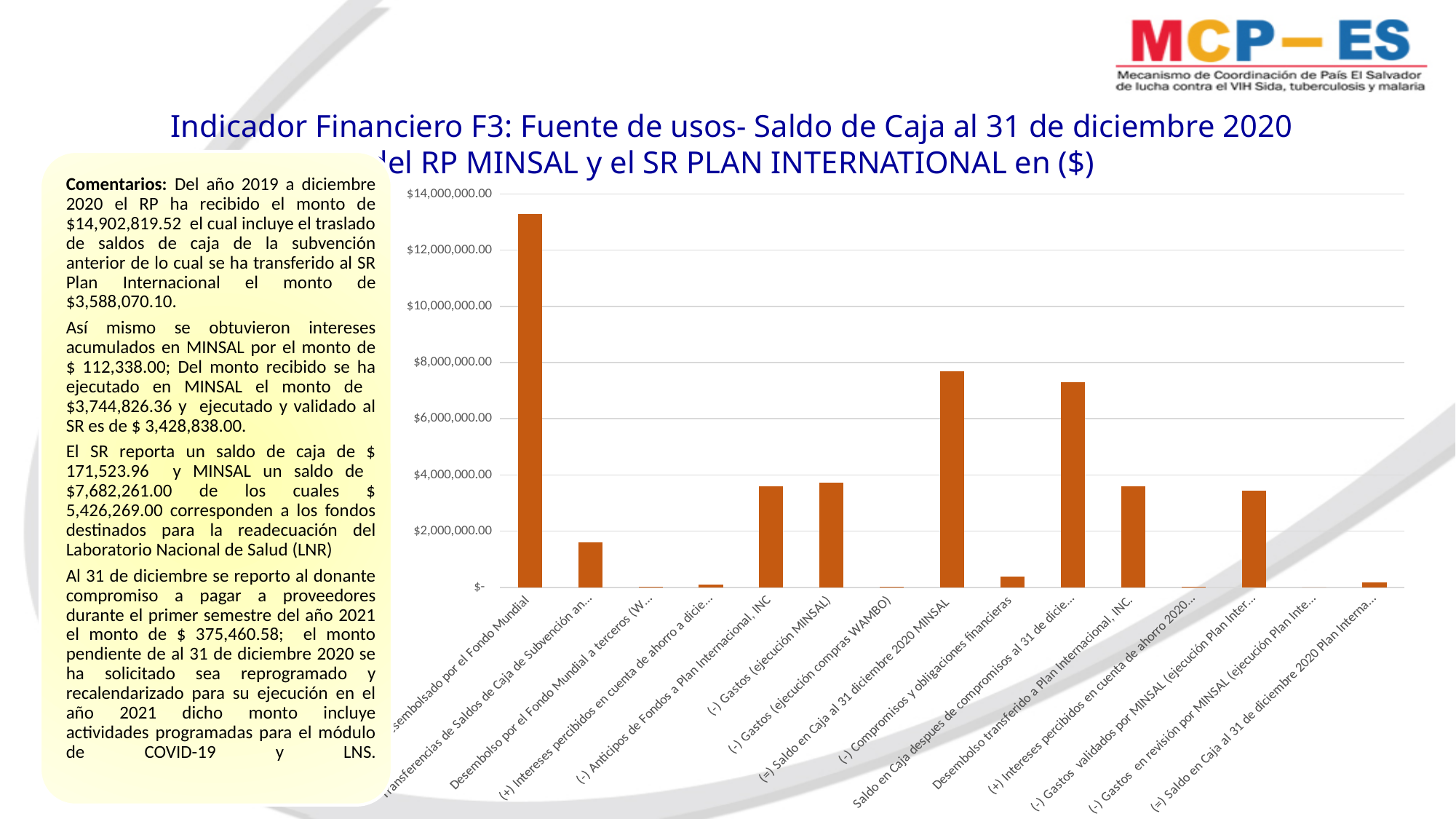
Which category has the highest value in the chart? Desembolsado por el Fondo Mundial How many bars (categories) are plotted in the chart? 15 Is the value for (-) Gastos (ejecución MINSAL) greater or less than $4,000,000.00? less Is the value for (-) Anticipos de Fondos a Plan Internacional, INC greater or less than $2,000,000.00? greater Which is larger: the value for Desembolsado por el Fondo Mundial or the value for (=) Saldo en Caja al 31 diciembre 2020 MINSAL? Desembolsado por el Fondo Mundial What is the highest value shown on the vertical axis of the chart? $14,000,000.00 Is the value for Desembolsado por el Fondo Mundial greater or less than $12,000,000.00? greater What kind of chart is shown on the slide? bar chart Which is larger: the value for (=) Saldo en Caja al 31 diciembre 2020 MINSAL or the value for Desembolso transferido a Plan International, INC.? (=) Saldo en Caja al 31 diciembre 2020 MINSAL Which is larger: the value for (-) Compromisos y obligaciones financieras or the value for (-) Gastos (ejecución MINSAL)? (-) Gastos (ejecución MINSAL)